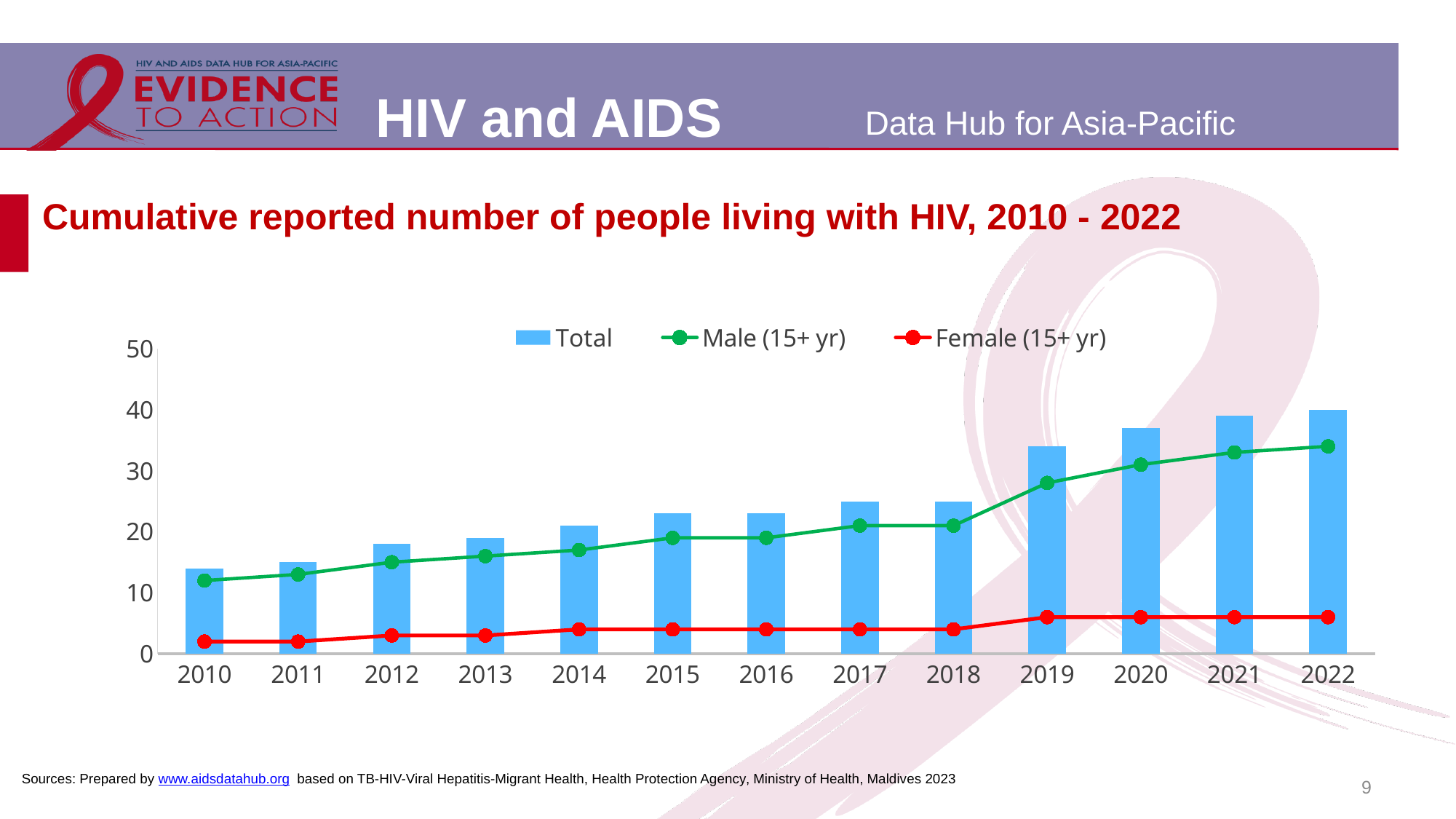
Which is larger in 2020, the Male (15+ yr) value or the Female (15+ yr) value? Male (15+ yr) What kind of chart is shown on the slide? Combined bar and line chart Is the Female (15+ yr) value for 2022 greater or less than 10? less What colour is the line for Female (15+ yr)? Red How many series does the legend list? 3 Which year has the highest Total bar? 2022 Is the Total value for 2019 greater or less than 30? greater Is the Male (15+ yr) value for 2022 greater or less than 30? greater Which year has the lowest Total bar? 2010 How many years are shown on the x axis? 13 Does the Total series rise or fall from 2010 to 2022? Rise